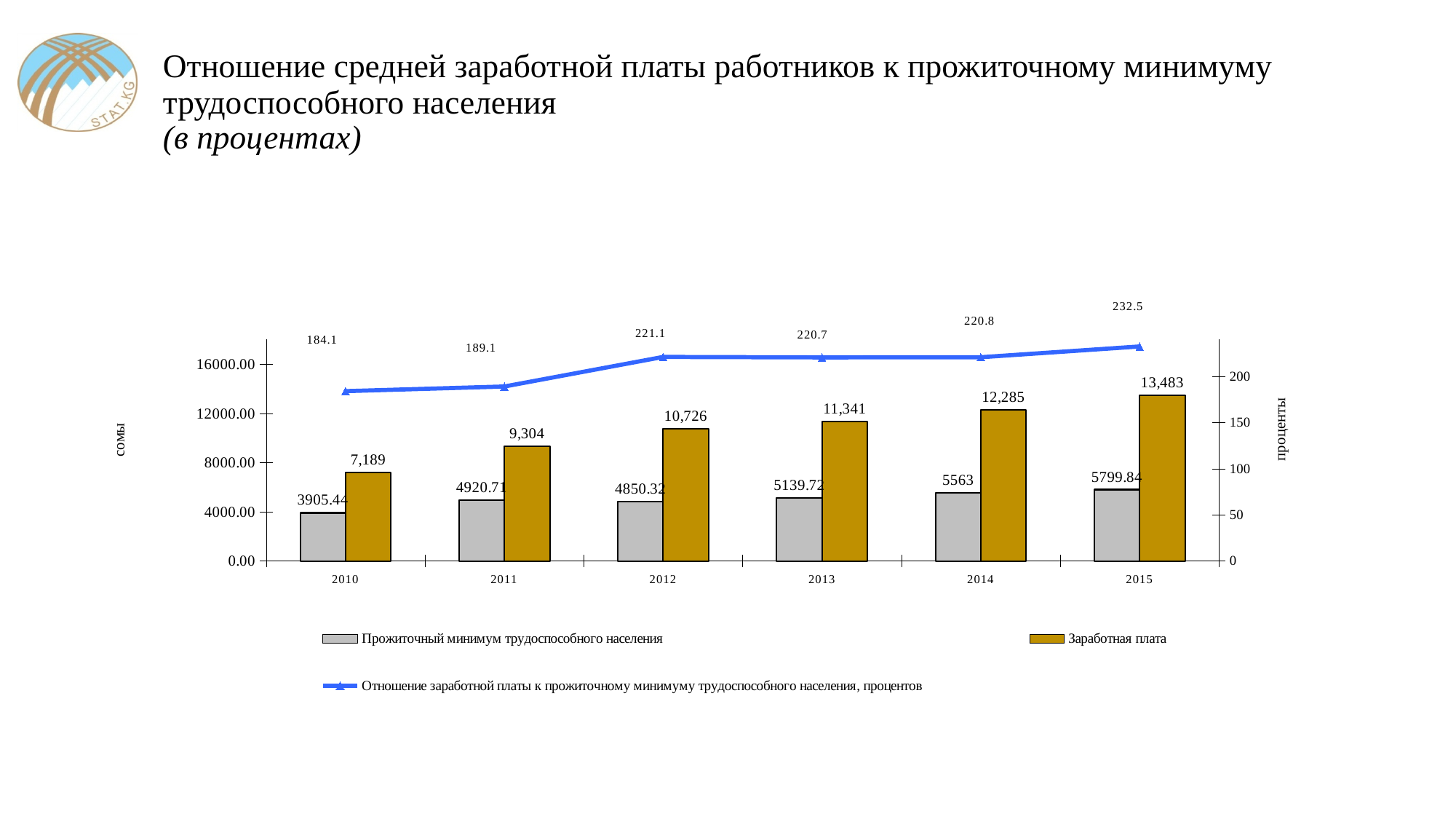
In which year is the ratio of wages to the subsistence minimum (line series) highest? 2015 How many years are shown on the x axis? 6 What is the value of the wage (Заработная плата) bar for 2015? 13,483 What kind of chart is shown on the slide? Combined bar and line chart What is the ratio of wages to the subsistence minimum (the line series) shown for 2012? 221.1 Which is larger: the subsistence minimum for 2011 or for 2012? 2011 How many series does the legend list? 3 In which year is the subsistence minimum bar lowest? 2010 Do the wage (Заработная плата) bars rise or fall from 2010 to 2015? Rise By how much did the ratio (line series) change from 2010 (184.1) to 2015 (232.5)? 48.4 What is the difference between the wage value for 2015 and the wage value for 2010? 6,294 What is the subsistence minimum (Прожиточный минимум трудоспособного населения) value shown for 2010? 3905.44